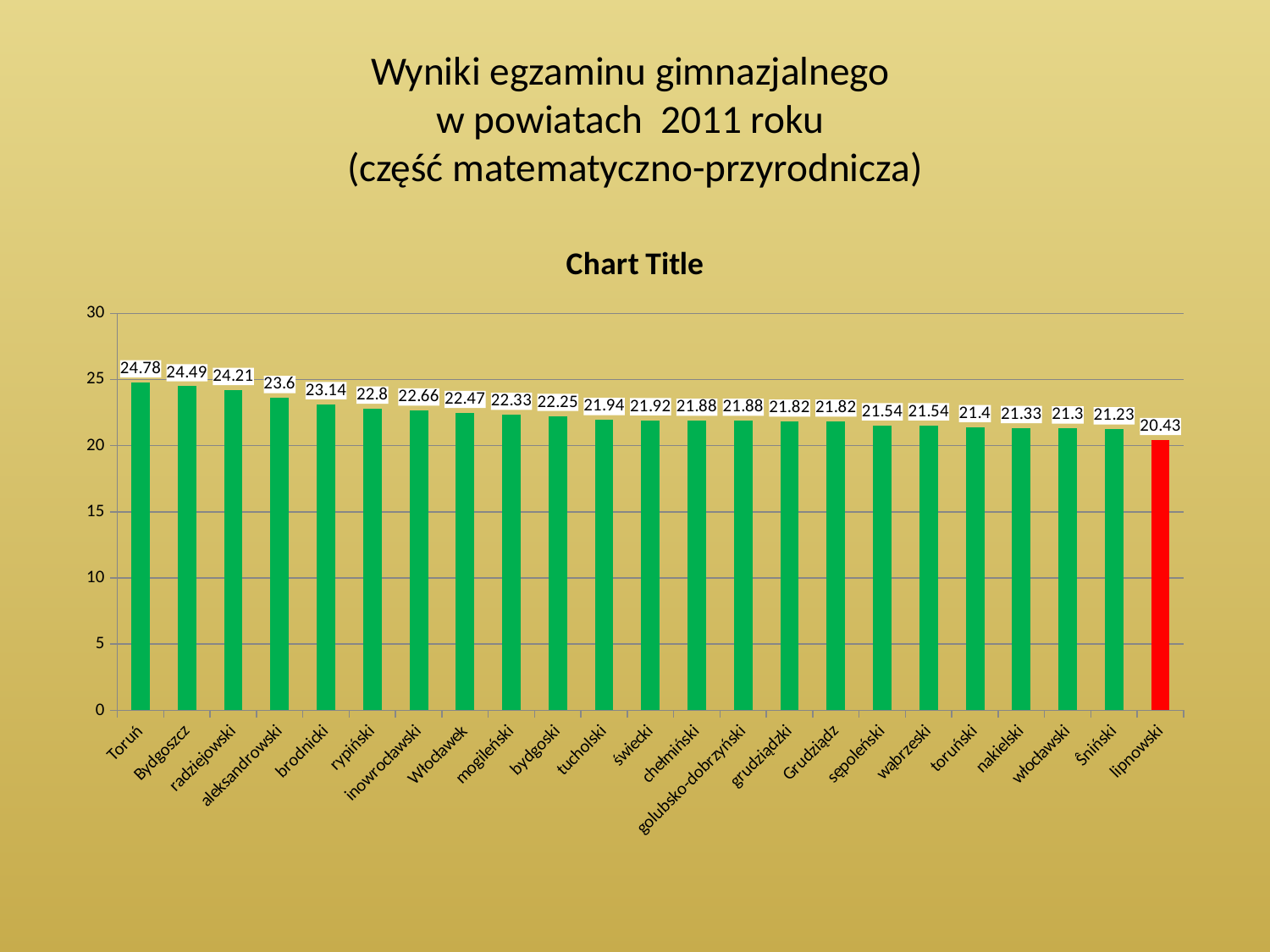
What is the value for brodnicki? 23.14 What is the value for Toruń? 24.78 What kind of chart is shown on the slide? bar chart Which bar is coloured red instead of green? lipnowski What is the value for lipnowski? 20.43 How many categories are shown on the x axis? 23 Which is larger, the value for Bydgoszcz or the value for Włocławek? Bydgoszcz Do the values rise or fall from left to right along the x axis? fall Which category has the lowest value? lipnowski Which category has the highest value? Toruń What is the difference between the values for Toruń and lipnowski? 4.35 What is the value for golubsko-dobrzyński? 21.88